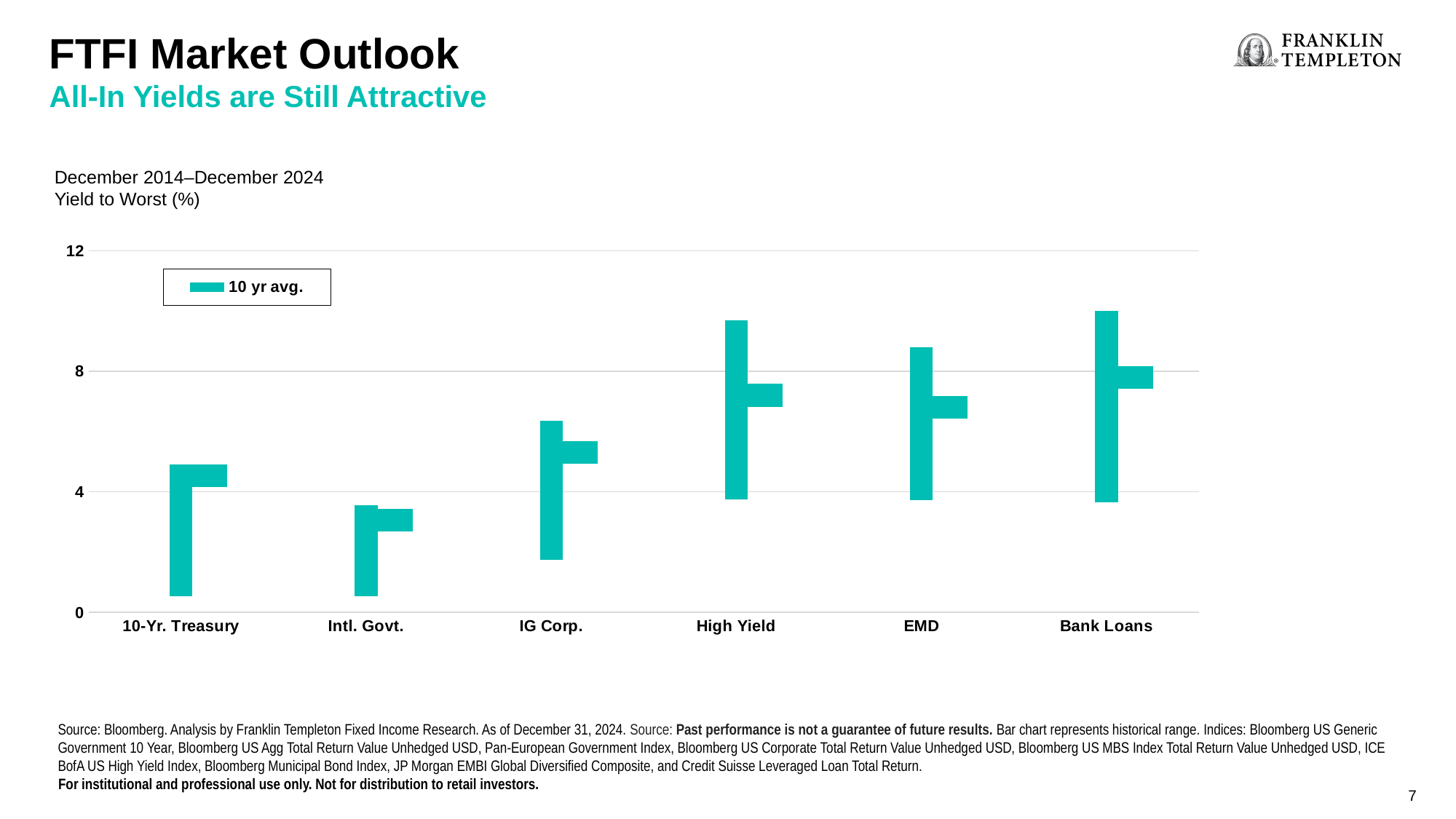
What is the legend entry shown on the chart? 10 yr avg. Which category has the highest 10 yr avg. marker? Bank Loans What period does the chart cover, according to the text above it? December 2014–December 2024 Is the 10 yr avg. marker for IG Corp. greater or less than 4? greater Is the 10 yr avg. marker for High Yield higher or lower than the one for IG Corp.? higher Which category has the lowest 10 yr avg. marker? Intl. Govt. Is the top of the historical range bar for Intl. Govt. greater or less than 4? less What kind of chart is shown on the slide? bar chart Is the top of the historical range bar for 10-Yr. Treasury greater or less than 4? greater How many categories are shown on the x axis of the chart? 6 How many series does the chart's legend list? 1